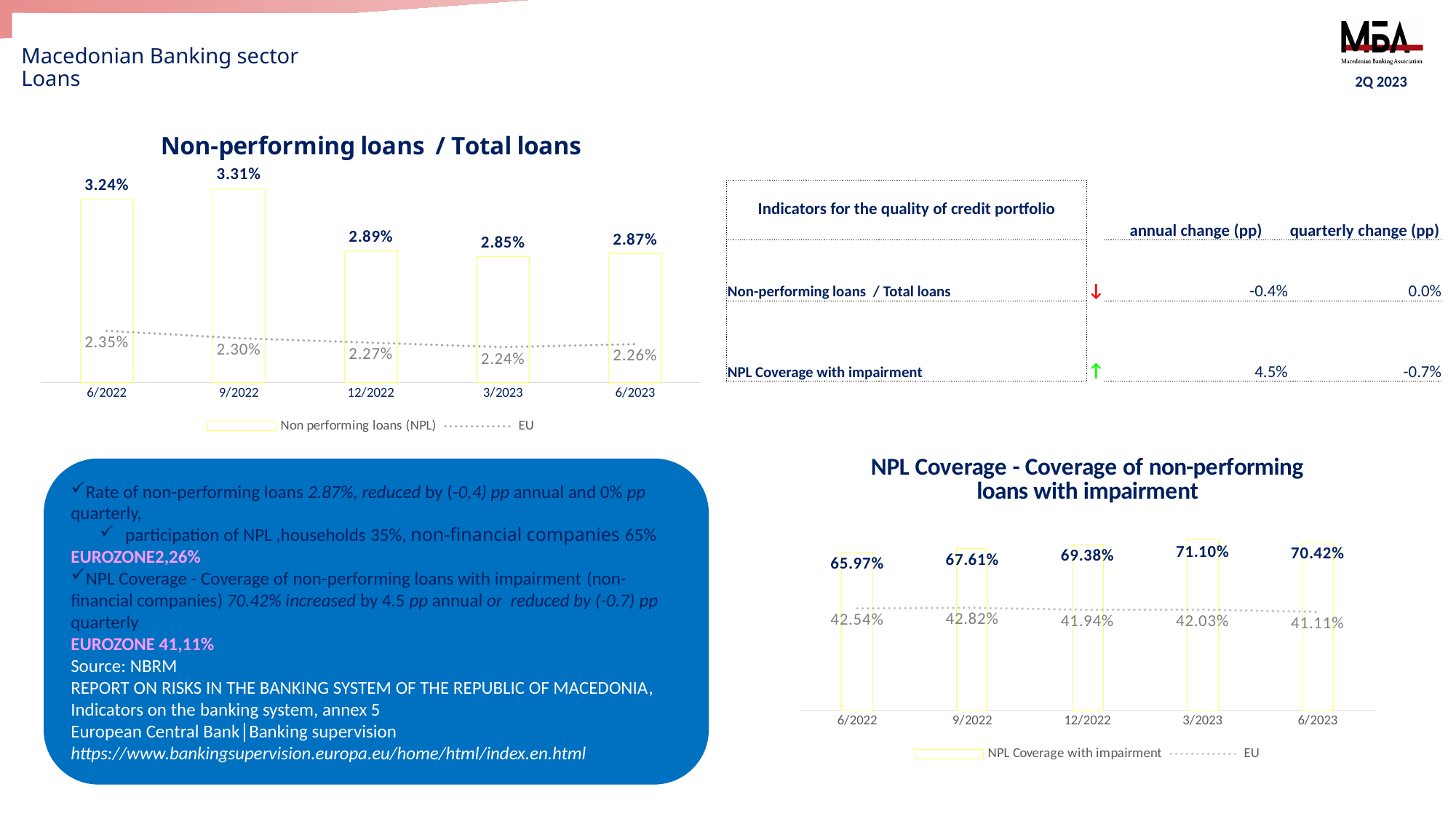
In the 'Non-performing loans / Total loans' chart, which period has the highest Non performing loans (NPL) value? 9/2022 In the 'NPL Coverage - Coverage of non-performing loans with impairment' chart, what is the NPL Coverage with impairment value for 3/2023? 71.10% In the 'NPL Coverage - Coverage of non-performing loans with impairment' chart, is the NPL Coverage with impairment value for 6/2023 larger or smaller than the value for 3/2023? smaller In the 'Non-performing loans / Total loans' chart, how many periods are shown on the x axis? 5 In the 'NPL Coverage - Coverage of non-performing loans with impairment' chart, what is the difference between the NPL Coverage with impairment value and the EU value for 6/2022? 23.43% In the 'Non-performing loans / Total loans' chart, which period has the lowest EU value? 3/2023 In the 'Non-performing loans / Total loans' chart, what is the EU value for 6/2023? 2.26% In the 'NPL Coverage - Coverage of non-performing loans with impairment' chart, which period has the lowest NPL Coverage with impairment value? 6/2022 In the 'Non-performing loans / Total loans' chart, what is the difference between the NPL value and the EU value for 6/2023? 0.61% In the 'NPL Coverage - Coverage of non-performing loans with impairment' chart, how many series does the legend list? 2 In the 'NPL Coverage - Coverage of non-performing loans with impairment' chart, what is the EU value for 12/2022? 41.94% In the 'Non-performing loans / Total loans' chart, what is the Non performing loans (NPL) value for 9/2022? 3.31%